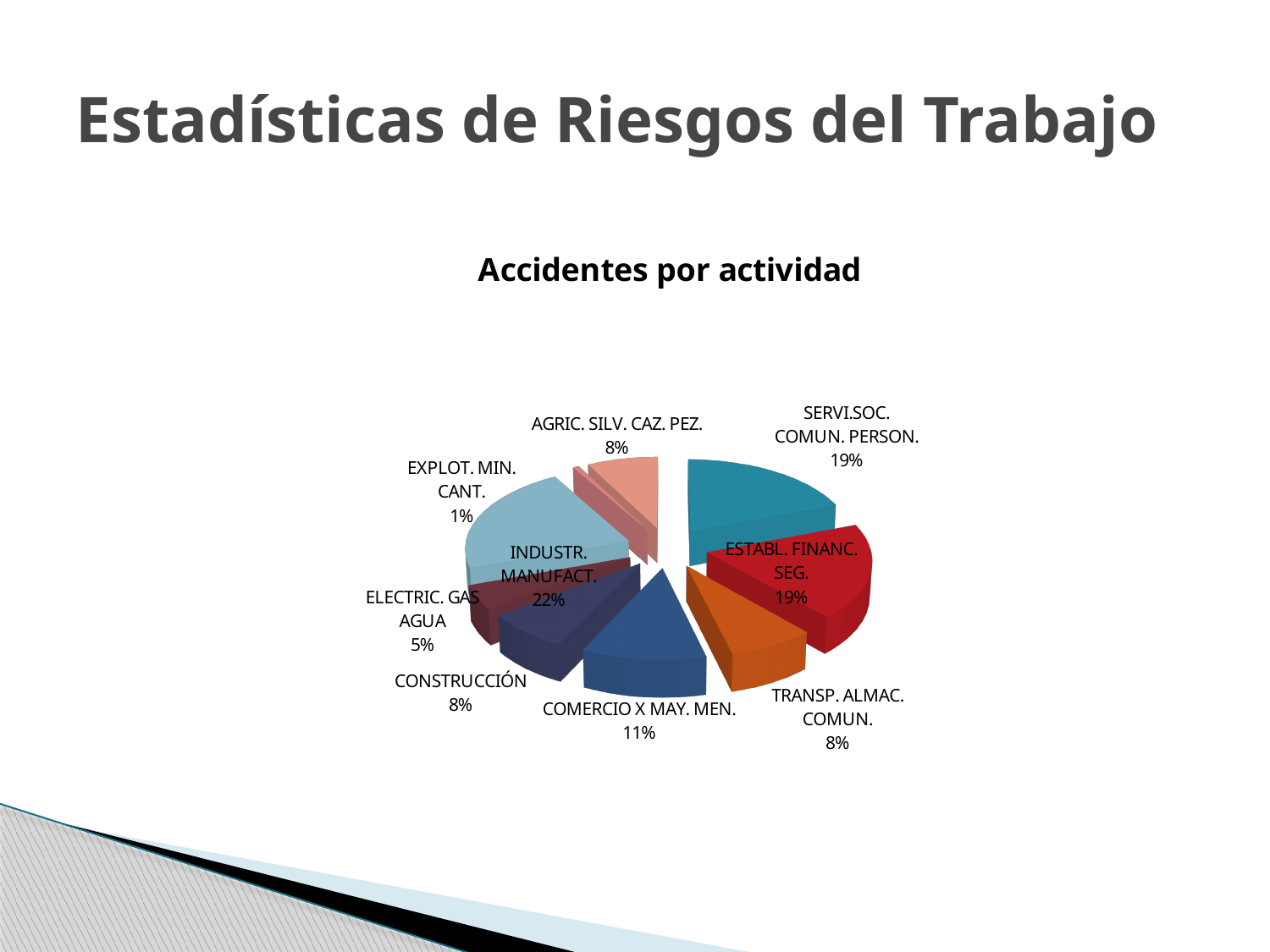
What percentage is shown for SERVI.SOC. COMUN. PERSON.? 19% Which activity has the largest share of accidents? INDUSTR. MANUFACT. What is the difference in percentage points between ESTABL. FINANC. SEG. and ELECTRIC. GAS AGUA? 14 What percentage is shown for ELECTRIC. GAS AGUA? 5% What share of accidents corresponds to INDUSTR. MANUFACT.? 22% Which activity has the smallest share of accidents? EXPLOT. MIN. CANT. What percentage is shown for COMERCIO X MAY. MEN.? 11% What type of chart is shown on the slide? Pie chart How many categories (slices) does the pie chart have? 9 What is the title of the chart? Accidentes por actividad Which has a larger share, COMERCIO X MAY. MEN. or TRANSP. ALMAC. COMUN.? COMERCIO X MAY. MEN. What is the difference in percentage points between INDUSTR. MANUFACT. and CONSTRUCCIÓN? 14